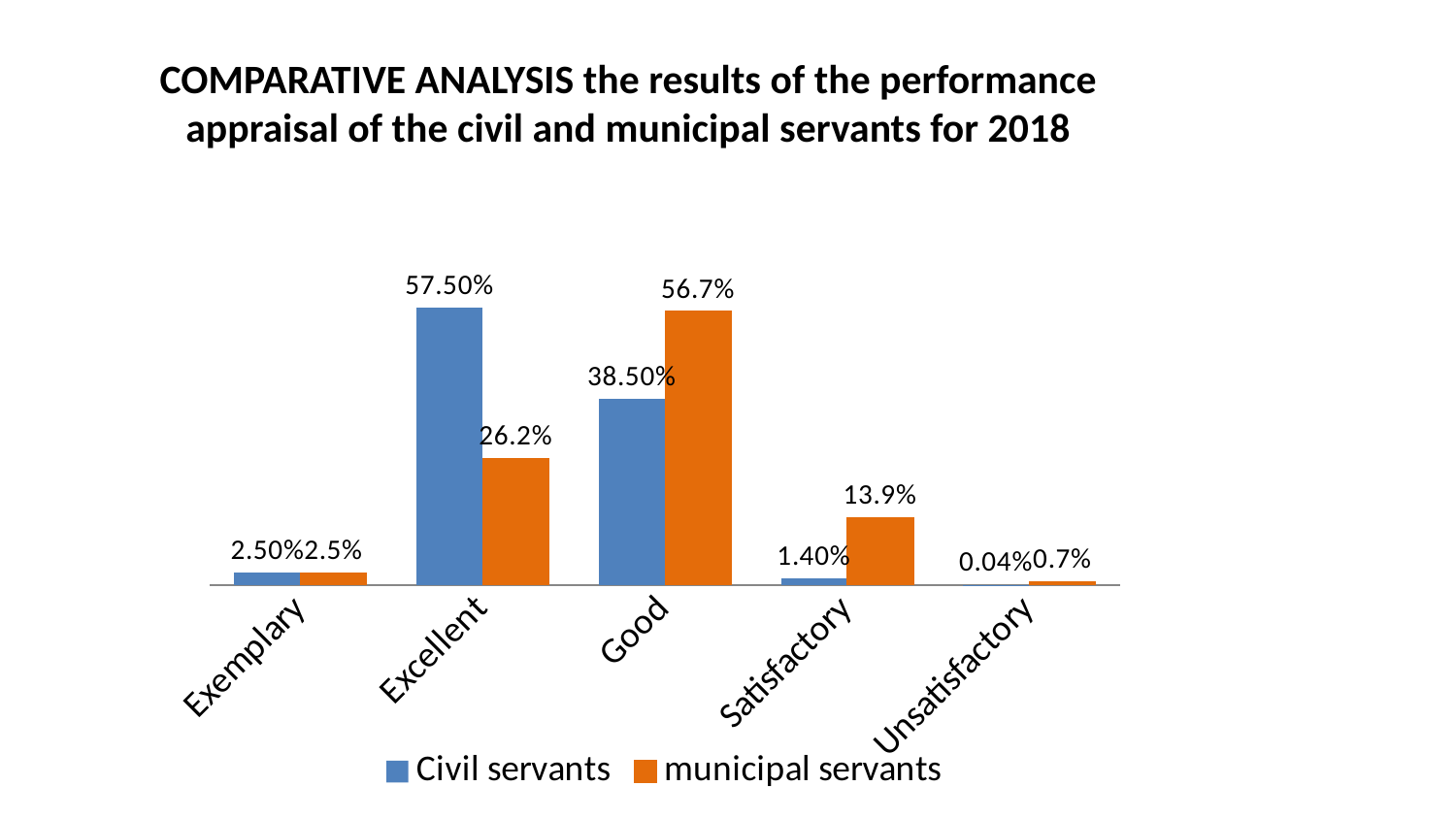
Which category has the lowest value for municipal servants? Unsatisfactory What is the value for Civil servants in the Excellent category? 57.50% How many series does the legend list? 2 What is the difference between the Civil servants and municipal servants values in the Excellent category? 31.3% What kind of chart is shown on the slide? Bar chart Which colour represents municipal servants in the chart? Orange How many categories are shown on the x axis? 5 What is the value for Civil servants in the Unsatisfactory category? 0.04% Which category has the highest value for Civil servants? Excellent What is the value for municipal servants in the Satisfactory category? 13.9% In the Good category, which series has the larger value, Civil servants or municipal servants? municipal servants What is the value for municipal servants in the Good category? 56.7%